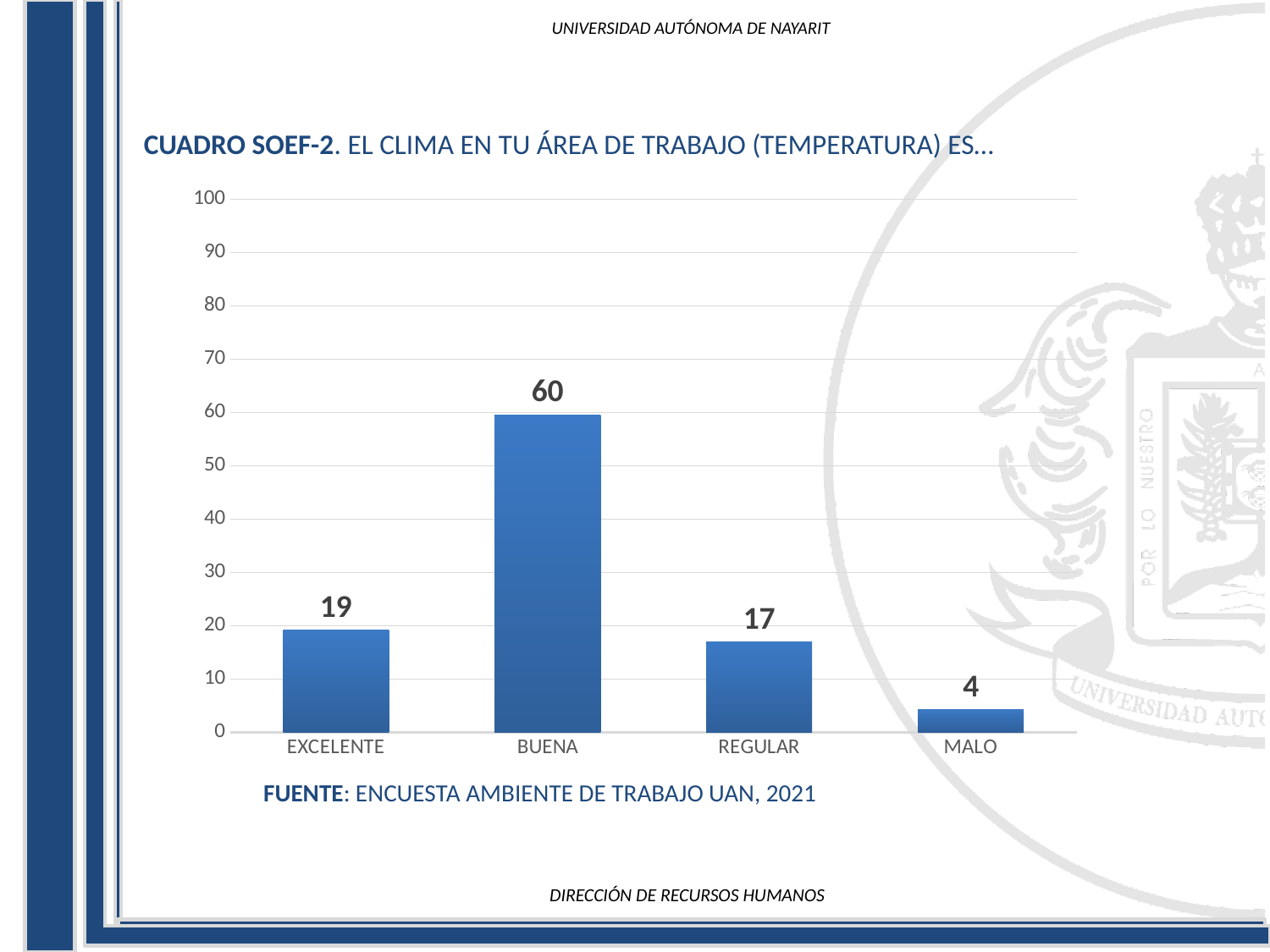
Which category has the highest value? BUENA What is the difference between the values for BUENA and REGULAR? 43 What kind of chart is shown on the slide? bar chart Which category has the lowest value? MALO What is the value for BUENA? 60 What source is cited below the chart? ENCUESTA AMBIENTE DE TRABAJO UAN, 2021 What is the difference between the values for EXCELENTE and MALO? 15 Is the value for BUENA greater or less than 50? greater What is the value for EXCELENTE? 19 How many categories are shown on the x axis? 4 Which is larger, the value for EXCELENTE or the value for REGULAR? EXCELENTE What is the value for MALO? 4